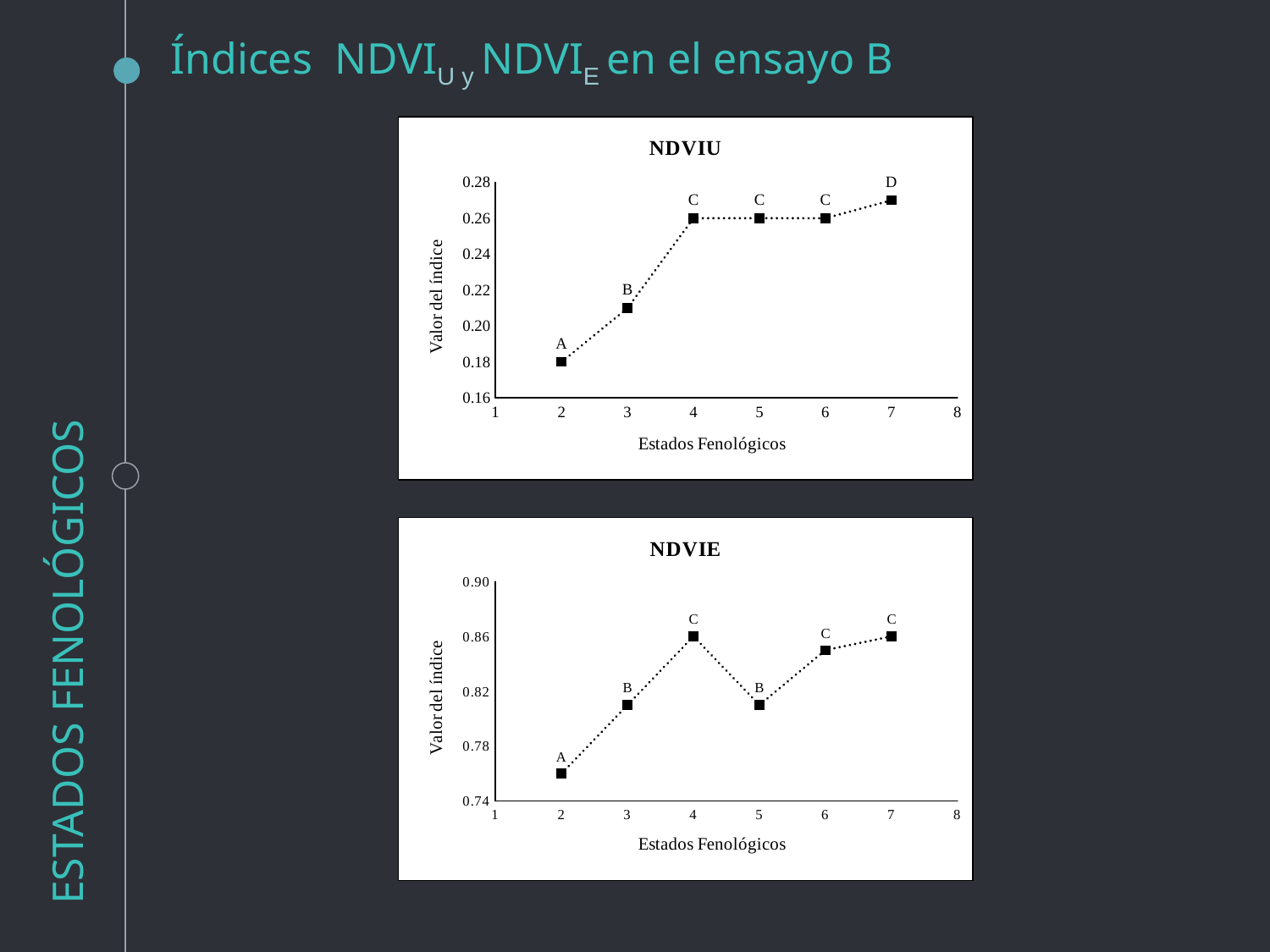
In the NDVIU chart, which phenological stage has the lowest index value? 2 In the NDVIU chart, what letter label is shown above the point at phenological stage 7? D In the NDVIE chart, which phenological stage has the lowest index value? 2 In the NDVIU chart, what is the index value at phenological stage 2? 0.18 In the NDVIU chart, how many data points are plotted? 6 What kind of chart is the NDVIU chart? line chart In the NDVIU chart, do the values generally rise or fall as the phenological stage increases? rise In the NDVIU chart, is the value at phenological stage 3 greater or less than 0.22? less In the NDVIU chart, which phenological stage has the highest index value? 7 In the NDVIE chart, what is the index value at phenological stage 4? 0.86 In the NDVIE chart, which has the larger value: phenological stage 4 or phenological stage 5? stage 4 In the NDVIU chart, what is the index value at phenological stage 4? 0.26